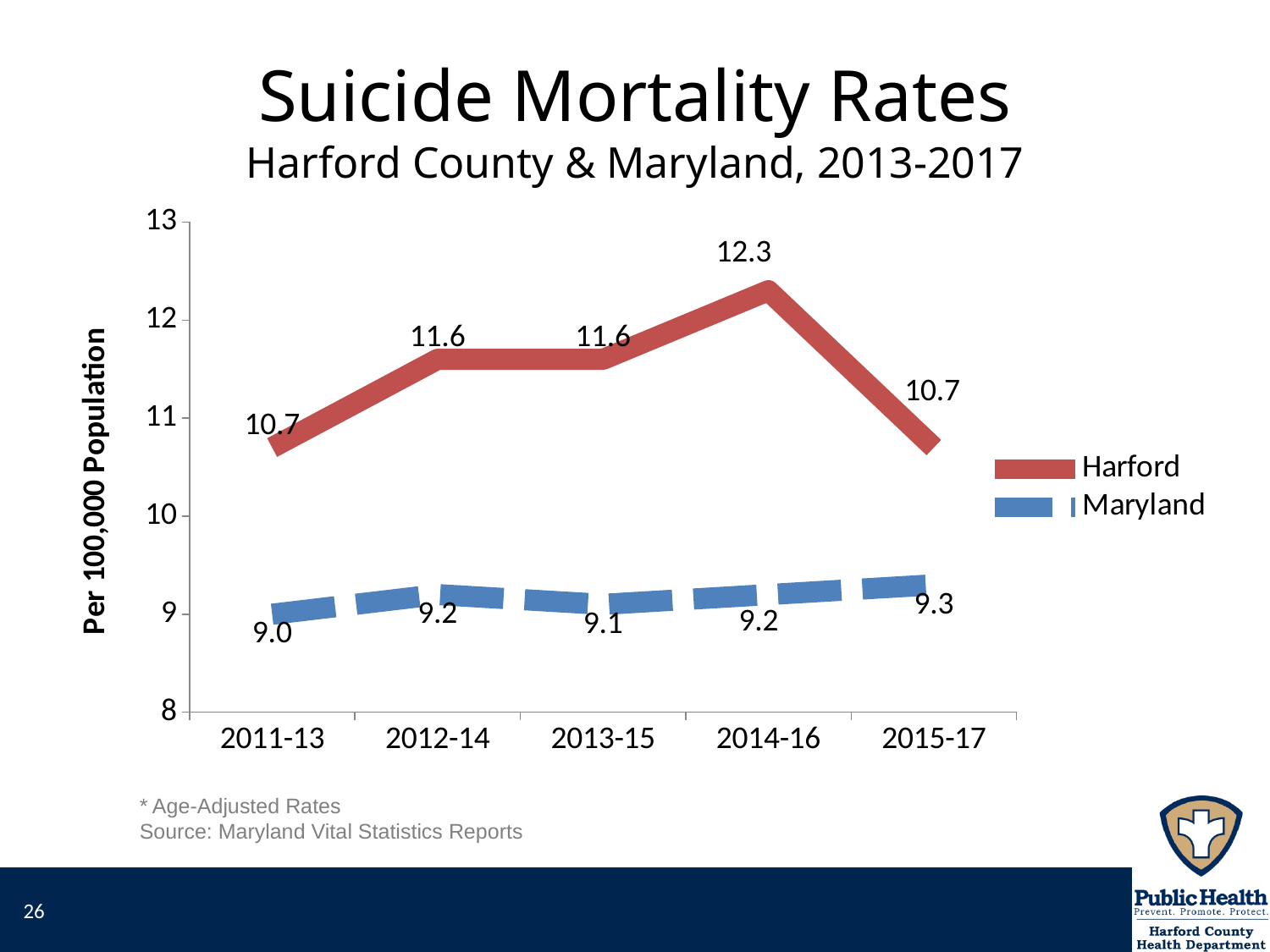
What is the Harford suicide mortality rate for 2014-16? 12.3 How many series does the legend list? 2 Which is larger in 2013-15, the Harford rate or the Maryland rate? Harford What is the difference between the Harford and Maryland rates in 2014-16? 3.1 What kind of chart is shown on the slide? Line chart What is the Harford rate for 2015-17? 10.7 What is the Maryland suicide mortality rate for 2011-13? 9.0 Does the Harford rate rise or fall from 2014-16 to 2015-17? Fall In which period is the Maryland rate lowest? 2011-13 In which period is the Harford rate highest? 2014-16 Is the Harford rate for 2012-14 greater or less than 11? greater How many time periods are shown on the x axis? 5